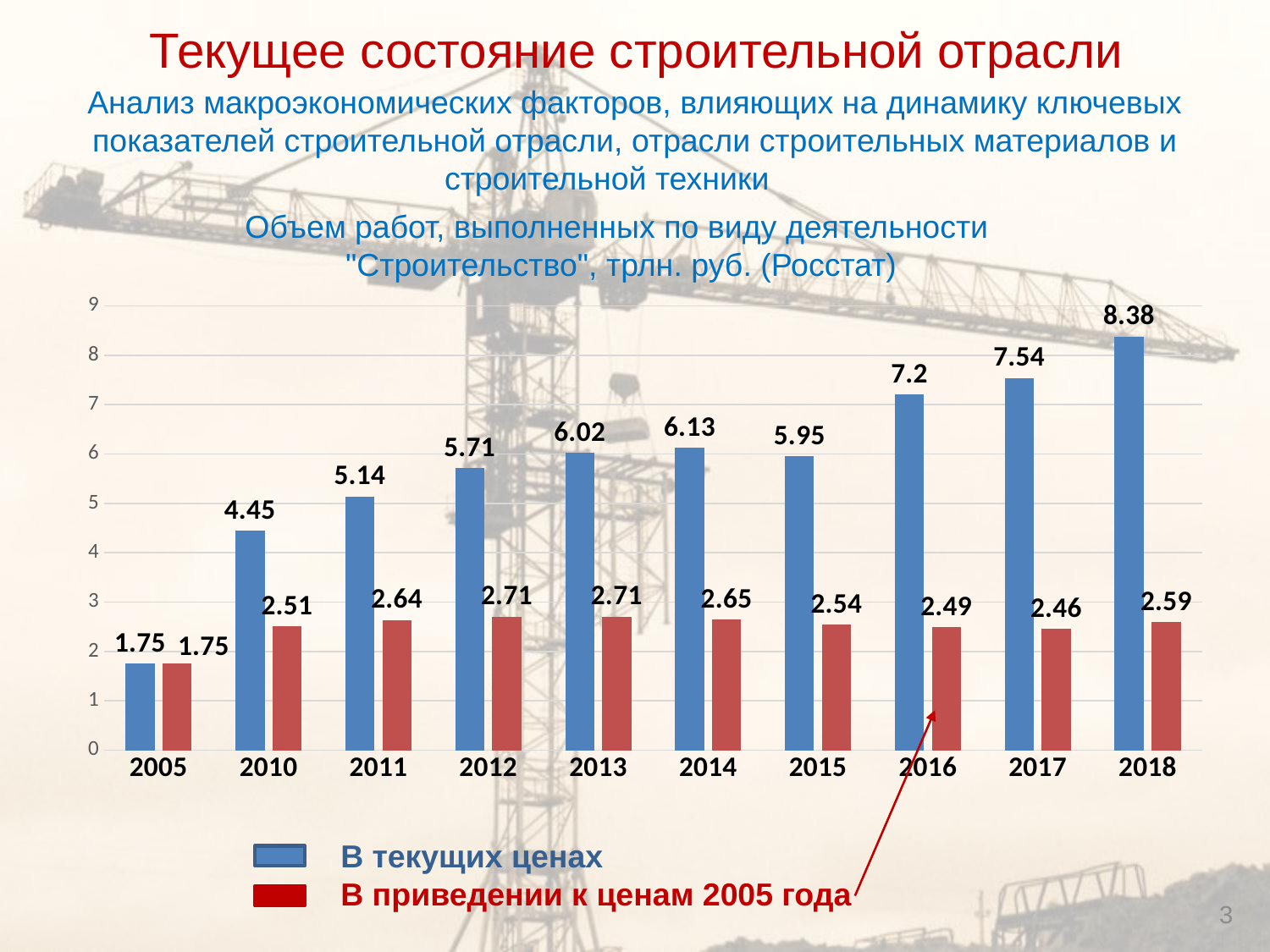
Which year has the highest value in the series "В текущих ценах"? 2018 How many series does the chart's legend list? 2 In the series "В текущих ценах", which is larger: the value for 2014 or the value for 2015? 2014 Do the values in the series "В текущих ценах" generally rise or fall from 2005 to 2018? rise What is the difference between the 2018 and 2017 values in the series "В текущих ценах"? 0.84 What is the value for 2012 in the series "В приведении к ценам 2005 года"? 2.71 How many years are shown on the x axis of the chart? 10 Which colour represents the series "В приведении к ценам 2005 года"? red Which year has the lowest value in the series "В приведении к ценам 2005 года"? 2005 What kind of chart is shown on the slide? bar chart Is the value for 2016 in the series "В текущих ценах" greater or less than 7? greater What is the value for 2018 in the series "В текущих ценах"? 8.38